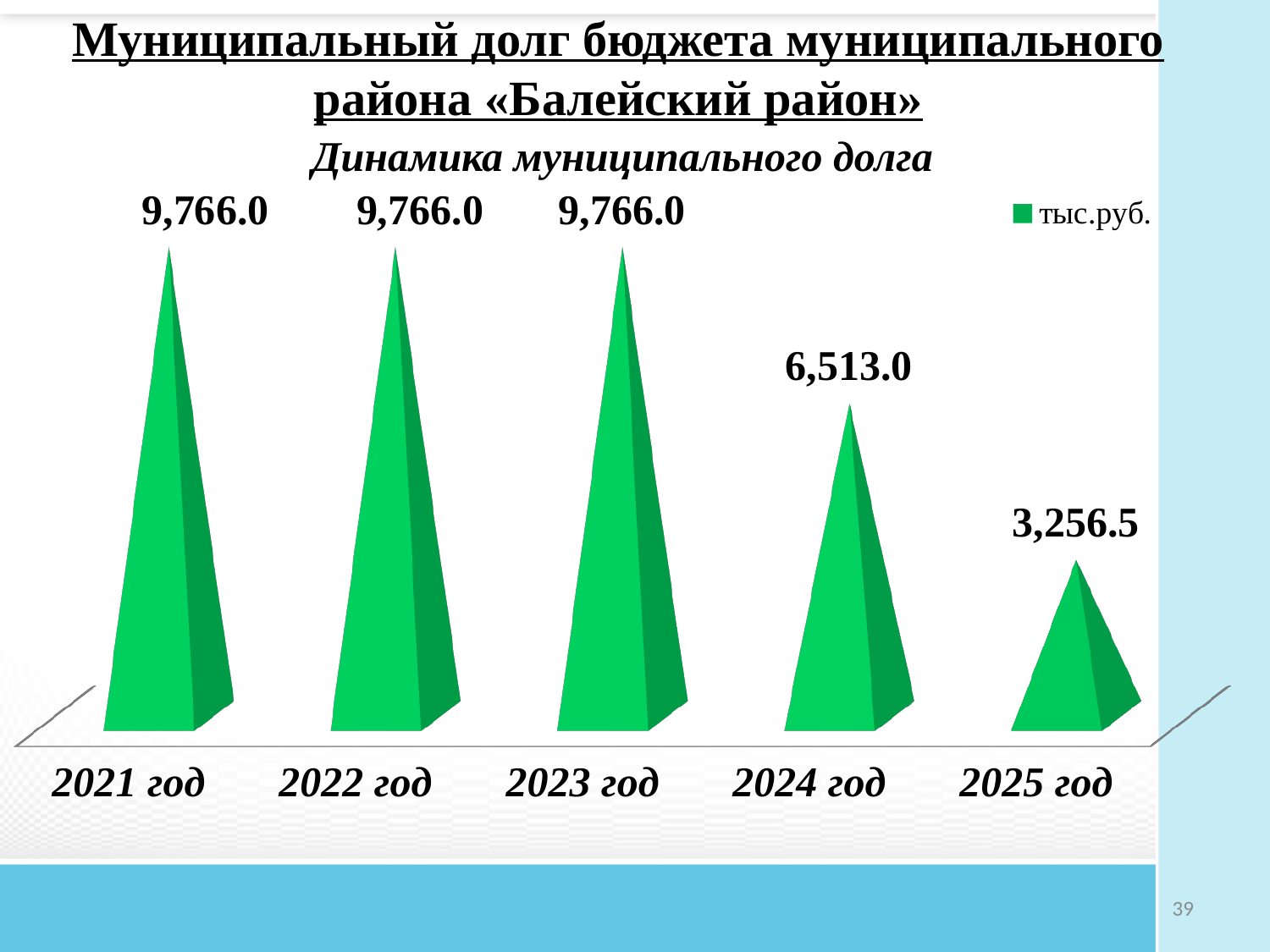
What is the value for 2023 год? 9,766.0 What is the difference between the values for 2021 год and 2025 год? 6,509.5 What kind of chart is this? bar chart What is the difference between the values for 2024 год and 2025 год? 3,256.5 Which year has the lowest value? 2025 год What is the value for 2024 год? 6,513.0 How many years are shown on the x axis? 5 What is the value for 2021 год? 9,766.0 What is the value for 2025 год? 3,256.5 Which is larger, the value for 2022 год or the value for 2024 год? 2022 год Do the values rise or fall from 2023 год to 2025 год? fall What is the difference between the values for 2023 год and 2024 год? 3,253.0